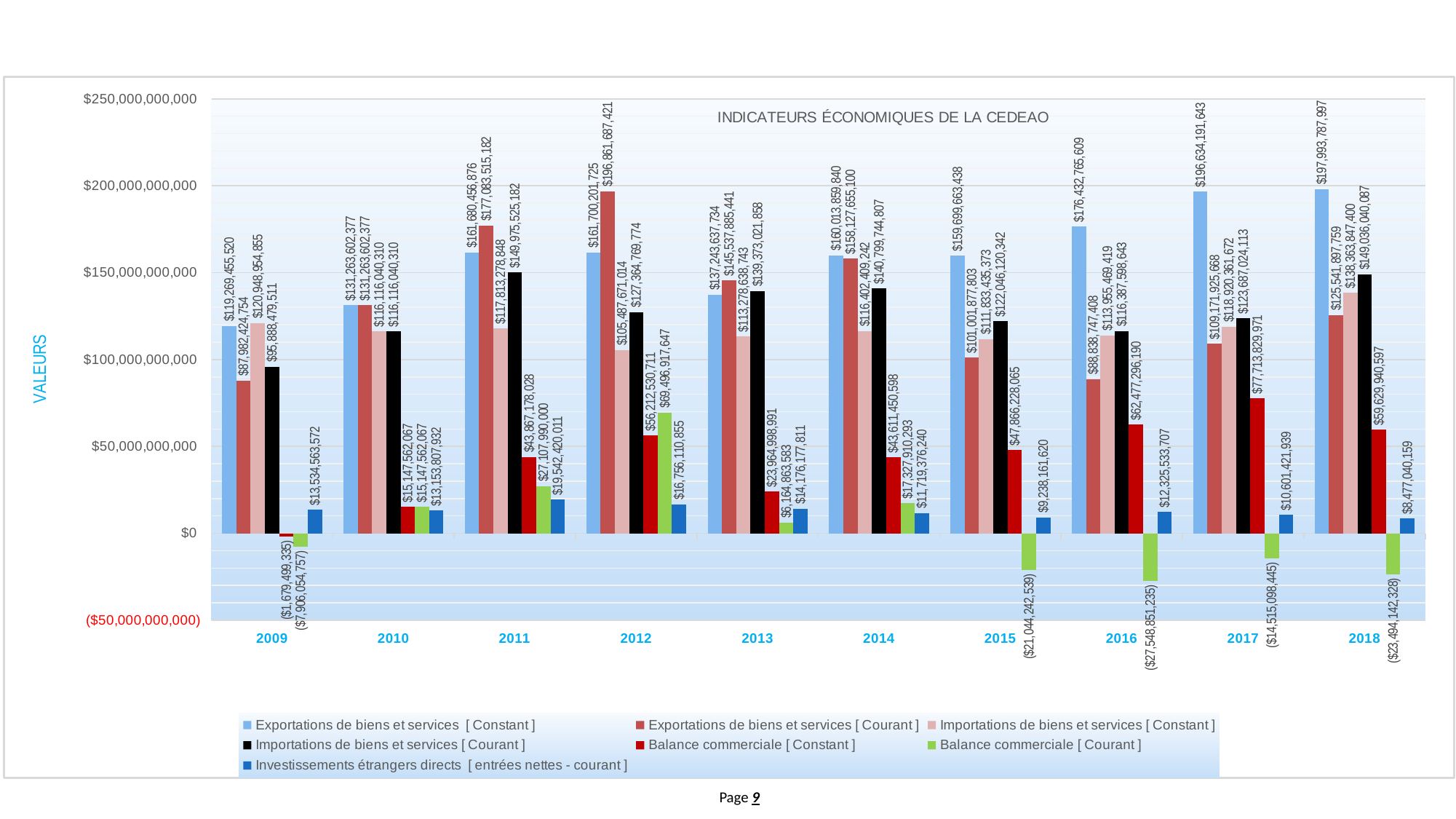
How many series does the legend list? 7 How many years are shown on the x axis? 10 What is the value of Exportations de biens et services [Constant] in 2009? $119,269,455,520 What is the difference between Exportations de biens et services [Constant] in 2018 and in 2009? $78,724,332,477 What is the value of Balance commerciale [Courant] in 2016? ($27,548,851,235) Is the value of Balance commerciale [Constant] in 2017 greater or less than $50,000,000,000? greater What kind of chart is shown on the slide? bar chart In which year is Investissements étrangers directs [entrées nettes - courant] highest? 2011 In which year is Exportations de biens et services [Courant] highest? 2012 What is the title of the chart? INDICATEURS ÉCONOMIQUES DE LA CEDEAO In 2012, which is larger: Exportations de biens et services [Courant] or Exportations de biens et services [Constant]? Exportations de biens et services [Courant] In which year is Balance commerciale [Courant] lowest? 2016